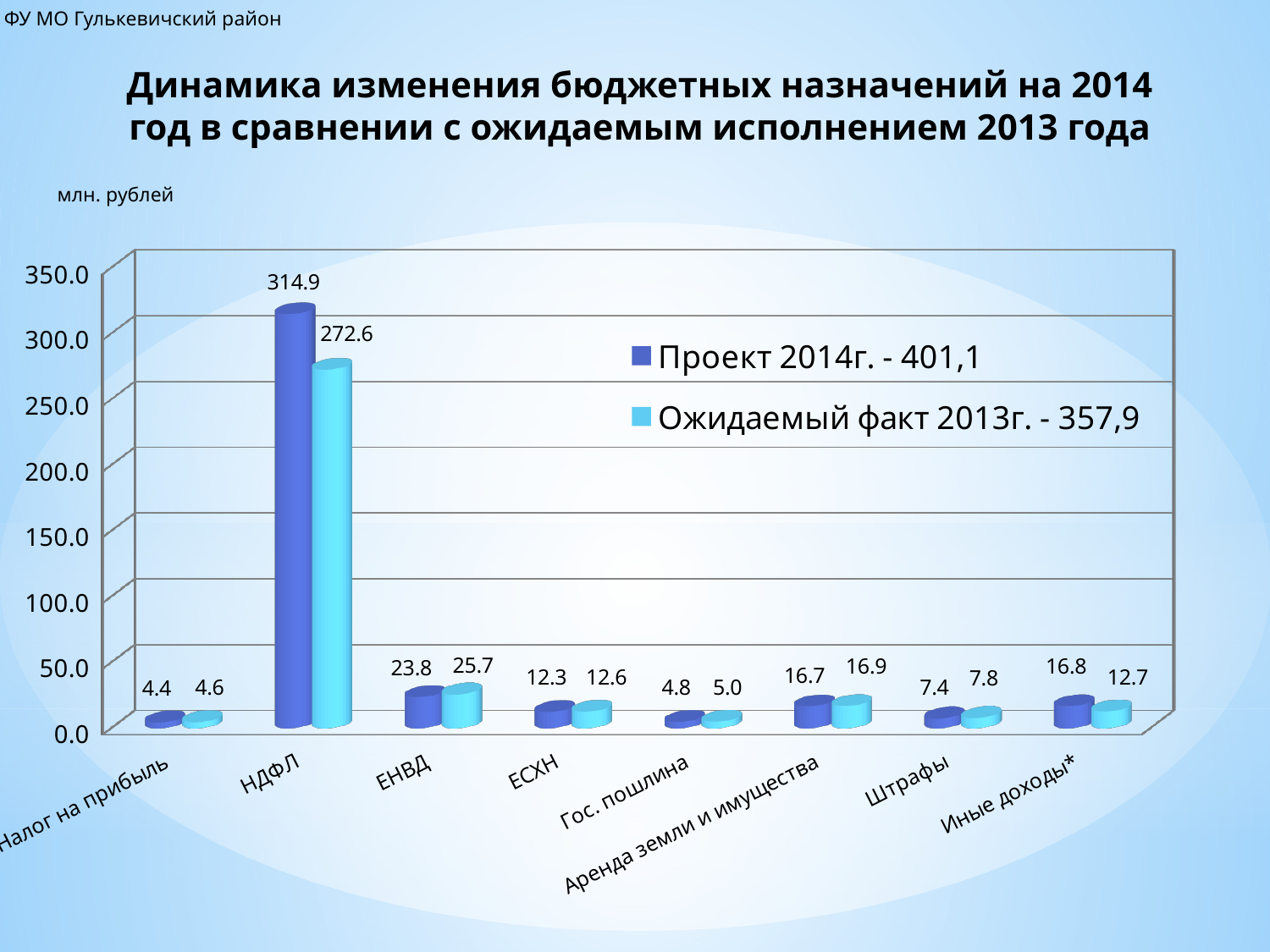
How many series does the legend list? 2 How many categories are shown on the x axis? 8 What is the value for Иные доходы* in the Проект 2014г. series? 16.8 Which category has the lowest value in the Проект 2014г. series? Налог на прибыль What is the difference between the Проект 2014г. and Ожидаемый факт 2013г. values for НДФЛ? 42.3 What is the value for НДФЛ in the Проект 2014г. series? 314.9 Which category has the highest value in the Проект 2014г. series? НДФЛ What kind of chart is shown on the slide? Bar chart What unit is indicated above the chart? млн. рублей What is the value for ЕНВД in the Ожидаемый факт 2013г. series? 25.7 For Иные доходы*, which is larger: the Проект 2014г. value or the Ожидаемый факт 2013г. value? Проект 2014г. What is the value for НДФЛ in the Ожидаемый факт 2013г. series? 272.6